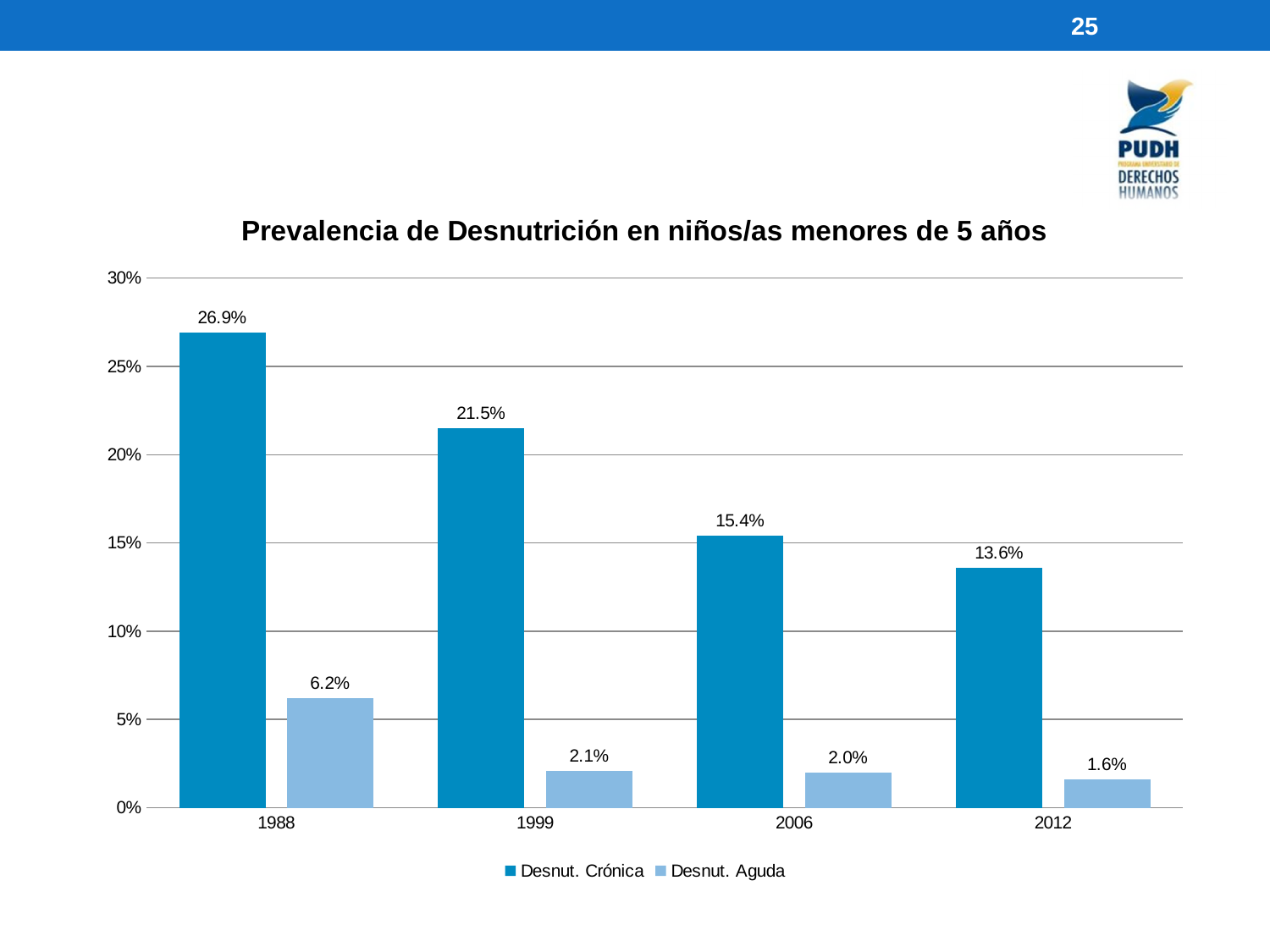
How many years are shown on the x axis? 4 Which year has the highest value for Desnut. Crónica? 1988 Which year has the lowest value for Desnut. Aguda? 2012 What is the value for Desnut. Crónica in 2006? 15.4% What is the difference between Desnut. Crónica in 1988 and in 2012? 13.3% Which is larger: Desnut. Aguda in 1988 or Desnut. Aguda in 1999? Desnut. Aguda in 1988 What is the value for Desnut. Aguda in 2012? 1.6% What kind of chart is shown on the slide? Bar chart Do the values for Desnut. Crónica rise or fall from 1988 to 2012? Fall How many series does the legend list? 2 Is the value for Desnut. Crónica in 1999 greater or less than 20%? greater What is the value for Desnut. Crónica in 1988? 26.9%